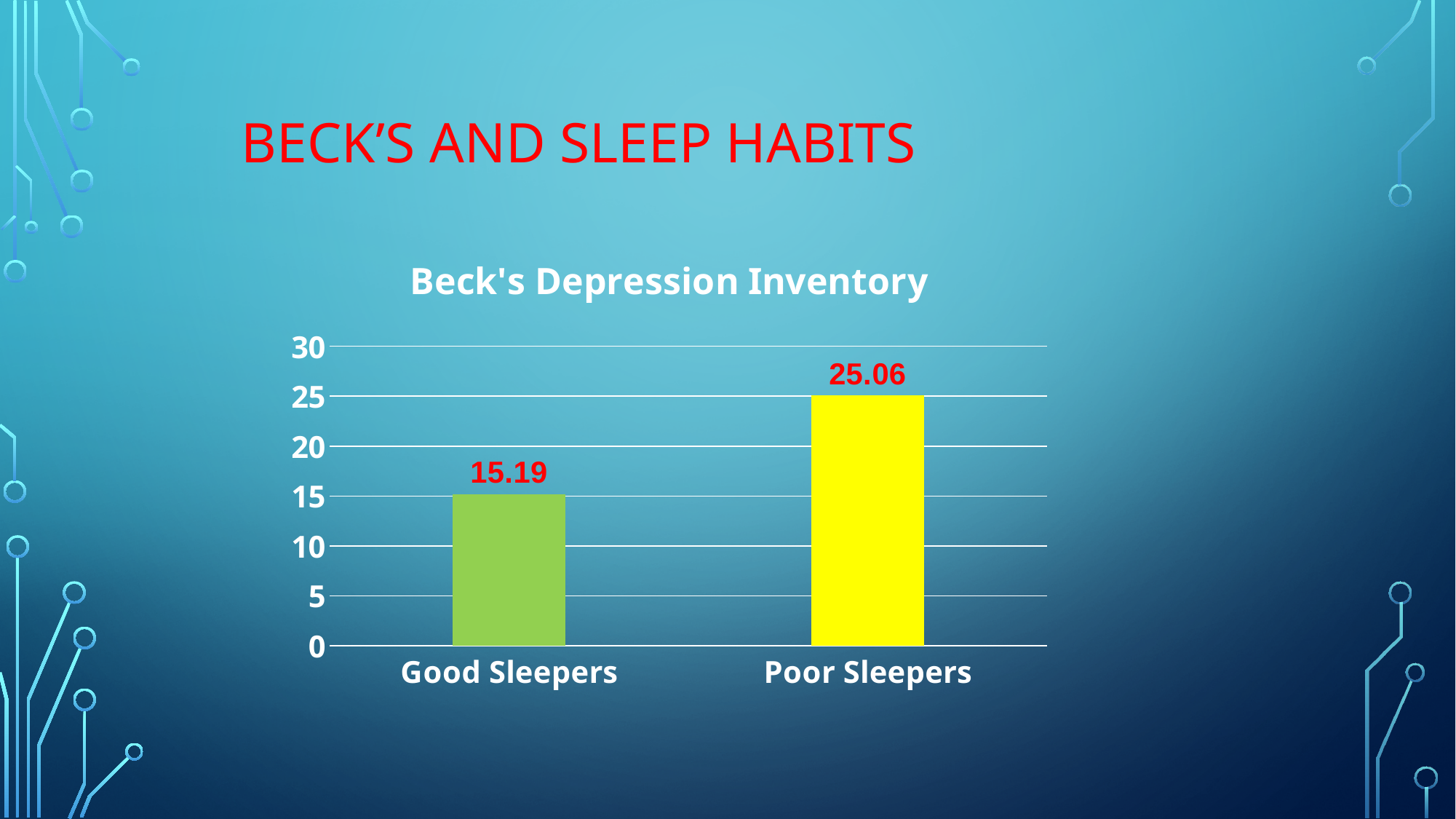
What colour is the bar for Poor Sleepers? Yellow Which category has the highest Beck's Depression Inventory value? Poor Sleepers What is the Beck's Depression Inventory value for Good Sleepers? 15.19 What kind of chart is shown on the slide? Bar chart What is the difference between the Poor Sleepers and Good Sleepers values? 9.87 What is the title of the chart? Beck's Depression Inventory Which category has the lowest Beck's Depression Inventory value? Good Sleepers Which is larger, the value for Good Sleepers or the value for Poor Sleepers? Poor Sleepers Is the value for Poor Sleepers greater or less than 20? greater Is the value for Good Sleepers greater or less than 20? less How many categories are shown on the chart? 2 What is the Beck's Depression Inventory value for Poor Sleepers? 25.06